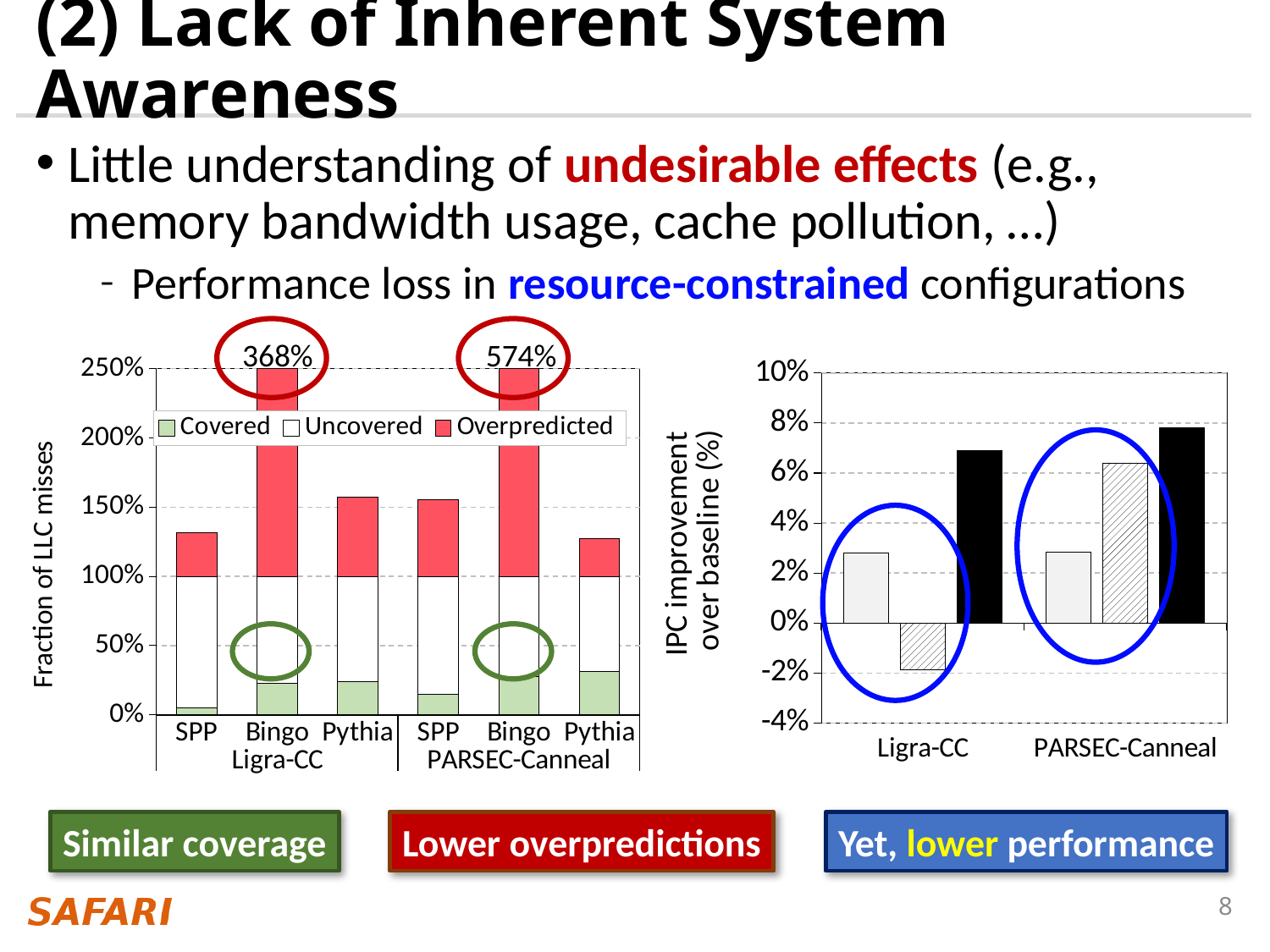
In the left chart, what value is labelled on the Bingo bar for Ligra-CC? 368% How many series does the legend of the left chart list? 3 What is the y-axis label of the right chart? IPC improvement over baseline (%) In the left chart, what is the difference between the labelled Bingo values for PARSEC-Canneal and Ligra-CC? 206% In the right chart, is the hatched bar for Ligra-CC greater or less than 0%? less In the left chart, is the total for SPP under Ligra-CC greater or less than 150%? less In the right chart, which black bar is taller: Ligra-CC or PARSEC-Canneal? PARSEC-Canneal How many bars are plotted in the left chart? 6 In the left chart, what value is labelled on the Bingo bar for PARSEC-Canneal? 574% How many categories are shown on the x axis of the right chart? 2 What kind of chart is the left chart (Fraction of LLC misses)? Stacked bar chart In the left chart, which bar has the highest total fraction of LLC misses? Bingo (PARSEC-Canneal)